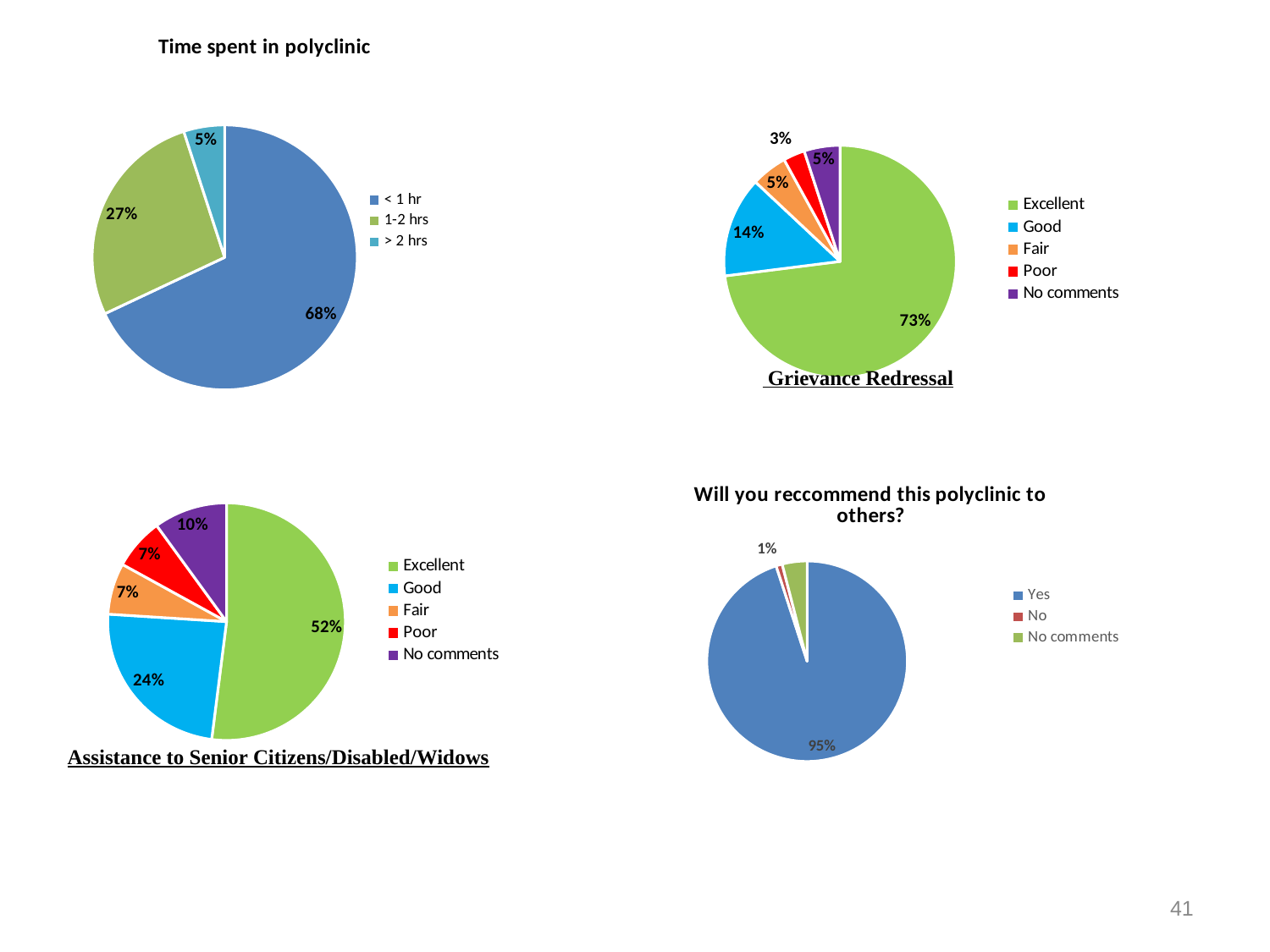
In the 'Time spent in polyclinic' chart, which category has the smallest slice? > 2 hrs In the 'Will you reccommend this polyclinic to others?' chart, what percentage answered 'Yes'? 95% In the 'Time spent in polyclinic' chart, what percentage of respondents spent less than 1 hour? 68% In the 'Assistance to Senior Citizens/Disabled/Widows' chart, what percentage is shown for 'No comments'? 10% In the 'Time spent in polyclinic' chart, what is the difference between the '< 1 hr' and '1-2 hrs' shares? 41% What kind of chart is used for 'Will you reccommend this polyclinic to others?'? Pie chart In the 'Grievance Redressal' chart, what percentage is labelled 'Excellent'? 73% In the 'Grievance Redressal' chart, what percentage is shown for 'Good'? 14% In the 'Grievance Redressal' chart, how many categories does the legend list? 5 In the 'Assistance to Senior Citizens/Disabled/Widows' chart, what percentage is shown for 'Good'? 24% In the 'Time spent in polyclinic' chart, what share is shown for '1-2 hrs'? 27% In the 'Assistance to Senior Citizens/Disabled/Widows' chart, which category has the largest slice? Excellent